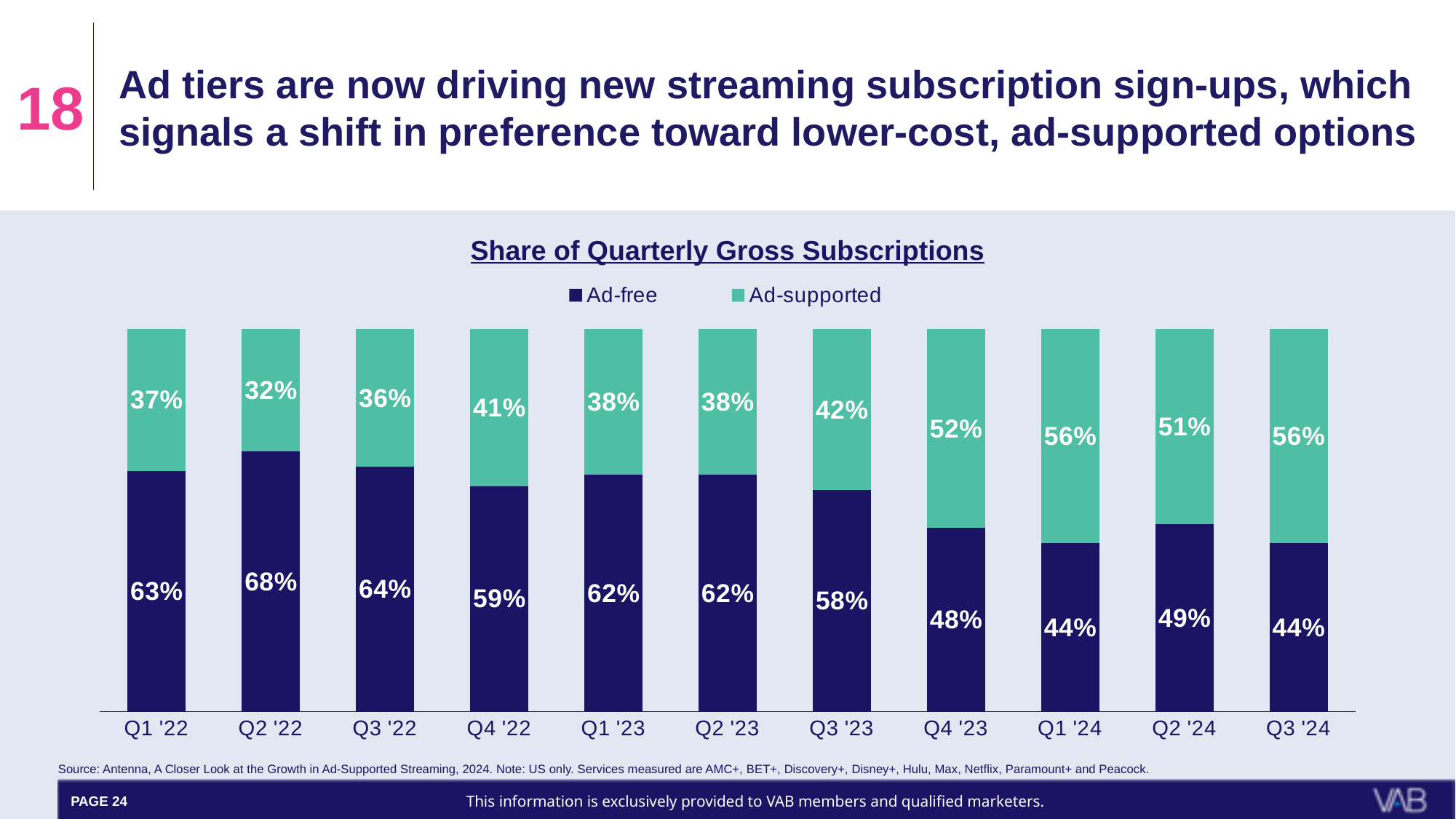
What is the difference between the Ad-free share in Q1 '22 and the Ad-free share in Q1 '24? 19% What is the title of the chart? Share of Quarterly Gross Subscriptions What kind of chart is shown on the slide? Stacked bar chart Which quarter has the lowest Ad-supported share? Q2 '22 What is the Ad-free share for Q2 '22? 68% How many quarters are shown on the x axis? 11 What is the Ad-supported share for Q3 '24? 56% How many series does the legend list? 2 Does the Ad-supported share generally rise or fall from Q1 '22 to Q3 '24? Rise What is the Ad-supported share for Q4 '23? 52% Which is larger in Q3 '23, the Ad-free share or the Ad-supported share? Ad-free Which quarter has the highest Ad-free share? Q2 '22